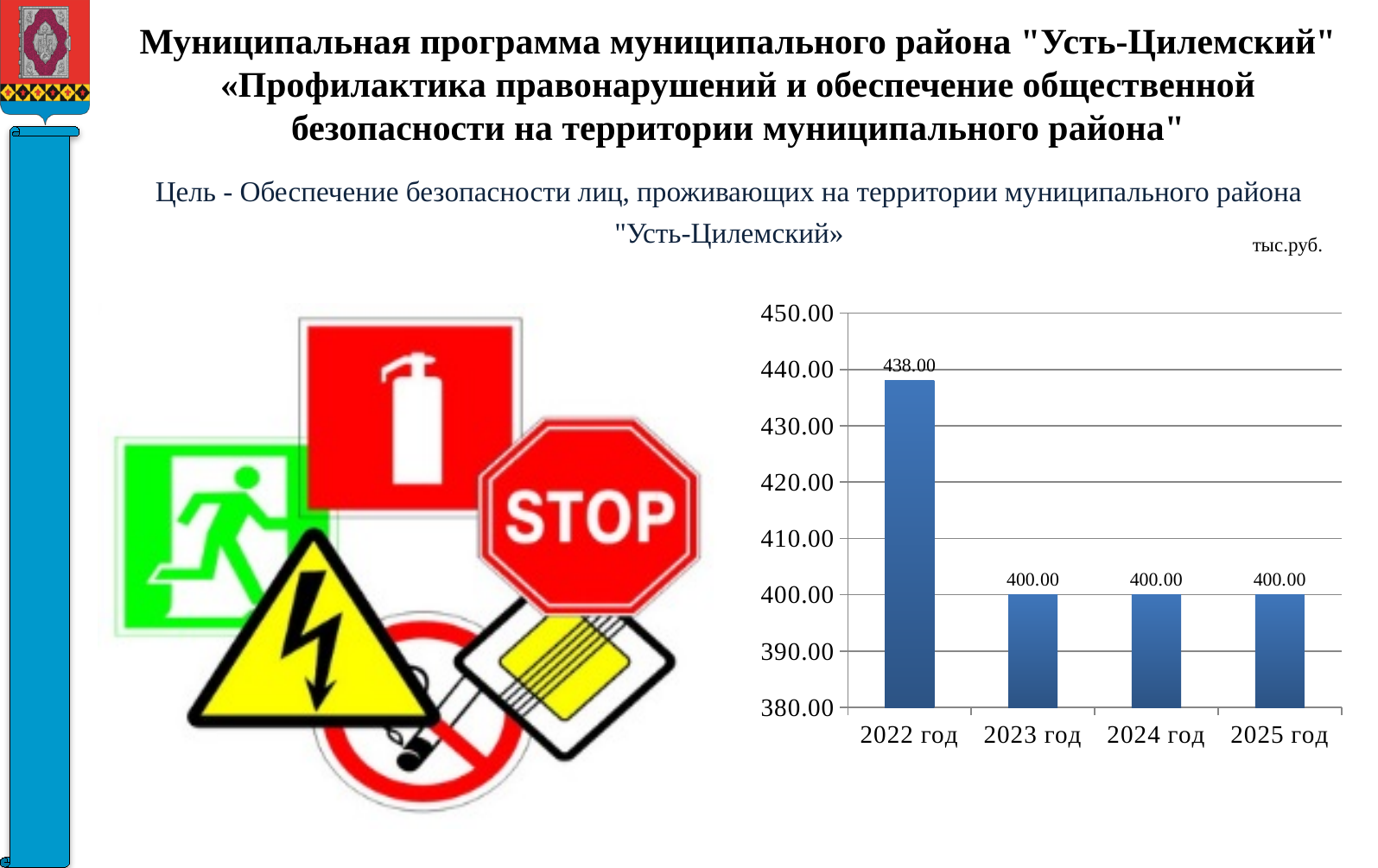
What is the difference between the values for 2022 год and 2023 год? 38.00 What kind of chart is shown on the slide? bar chart Is the value for 2022 год greater or less than 430.00? greater Which is larger, the value for 2022 год or the value for 2025 год? 2022 год What is the value for 2024 год? 400.00 What is the value for 2022 год? 438.00 What is the lowest value shown on the y axis of the chart? 380.00 Are the values for 2023 год, 2024 год and 2025 год the same? yes Do the values rise or fall from 2022 год to 2023 год? fall Which year has the highest value? 2022 год How many years are shown on the x axis of the chart? 4 What unit is indicated above the chart? тыс.руб.